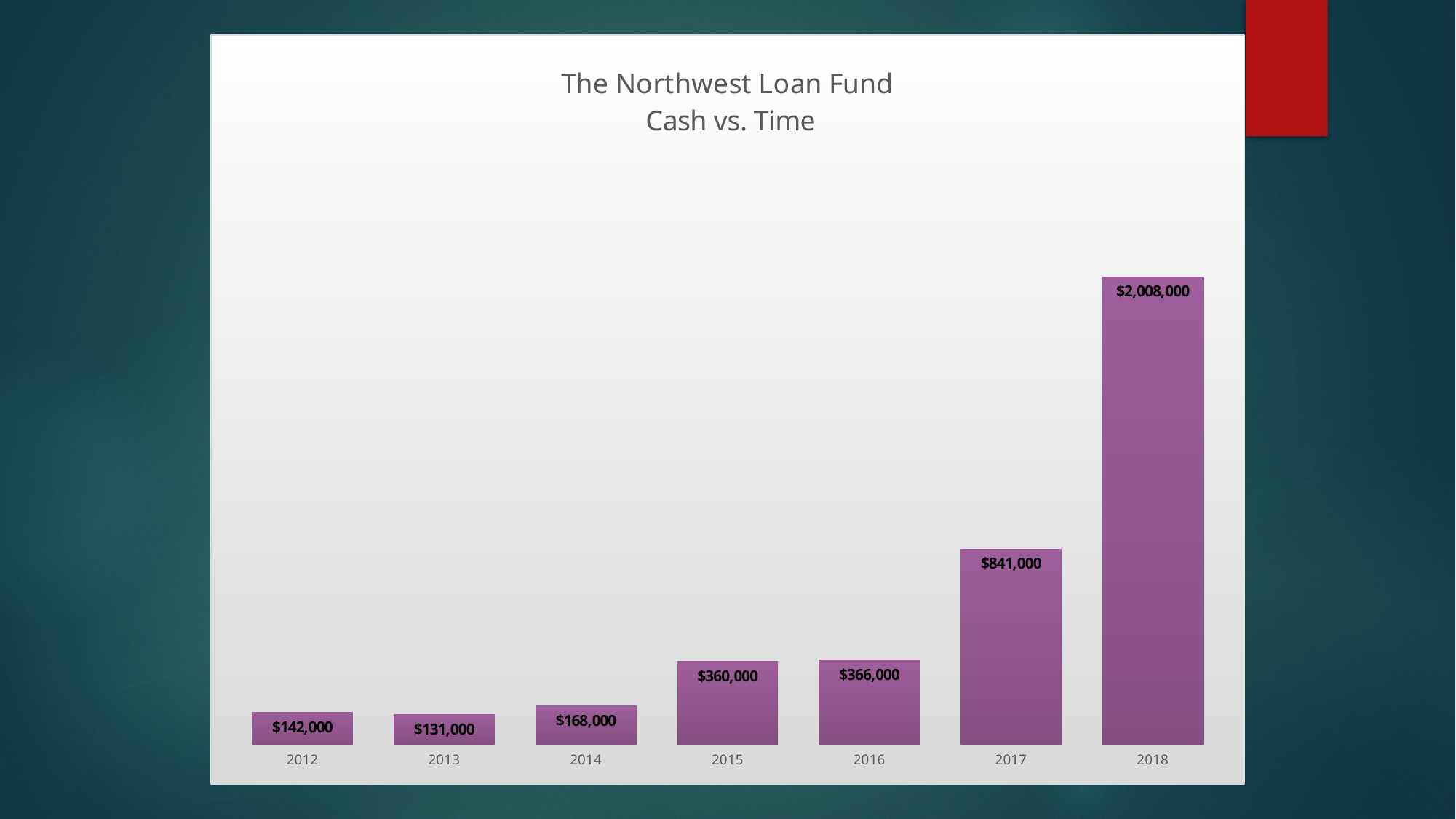
What is the difference between the values for 2014 and 2013? $37,000 How many years are shown on the x axis? 7 What is the value for 2015? $360,000 Which is larger, the value for 2012 or the value for 2014? 2014 What is the title of the chart? The Northwest Loan Fund Cash vs. Time What is the difference between the values for 2018 and 2017? $1,167,000 What is the value for 2017? $841,000 Which is larger, the value for 2016 or the value for 2017? 2017 What is the value for 2012? $142,000 Which year has the highest value? 2018 Which year has the lowest value? 2013 What kind of chart is shown on the slide? Bar chart